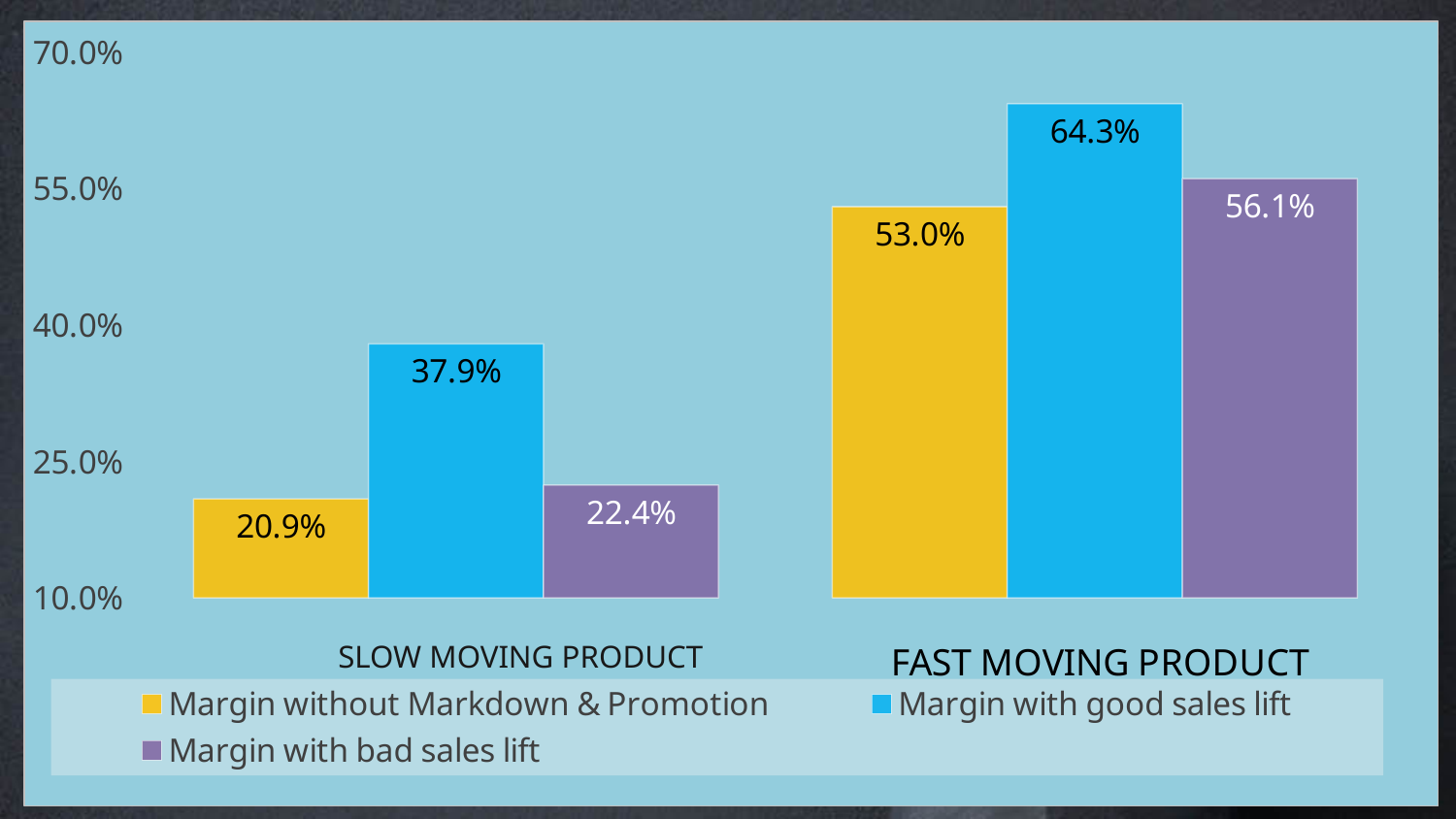
Which is larger: the Margin with bad sales lift for Fast Moving Product or the Margin without Markdown & Promotion for Fast Moving Product? Margin with bad sales lift What is the Margin without Markdown & Promotion for Fast Moving Product? 53.0% Which series has the lowest value for Slow Moving Product? Margin without Markdown & Promotion How many product categories are shown on the x axis? 2 Which series has the highest value for Fast Moving Product? Margin with good sales lift What is the Margin with bad sales lift for Fast Moving Product? 56.1% What is the difference between the Margin with good sales lift for Fast Moving Product and for Slow Moving Product? 26.4% What kind of chart is shown on the slide? Bar chart How many series does the legend list? 3 What is the Margin with bad sales lift for Slow Moving Product? 22.4% What is the difference between the Margin with good sales lift and the Margin without Markdown & Promotion for Fast Moving Product? 11.3% What is the Margin with good sales lift for Slow Moving Product? 37.9%